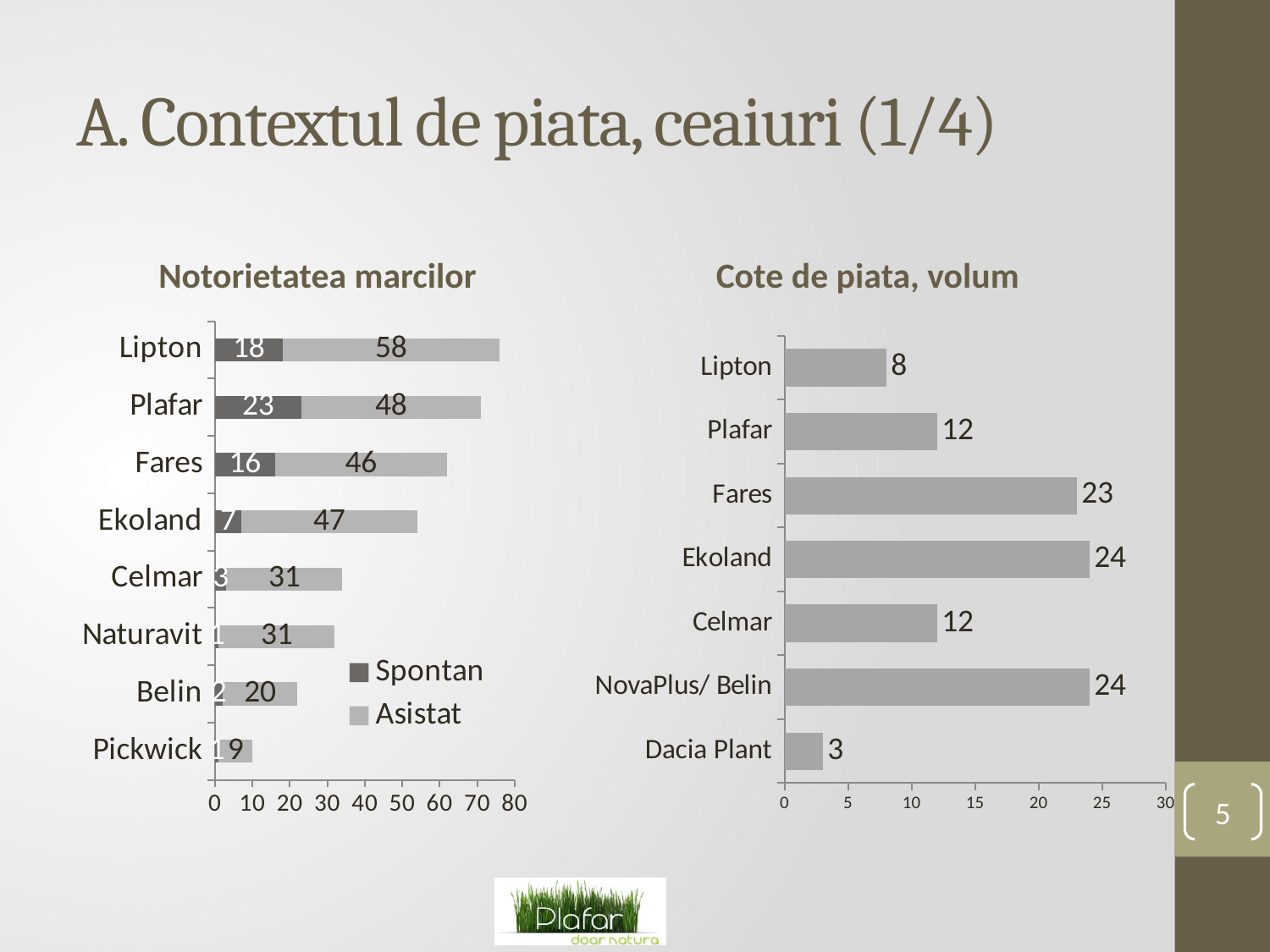
In the 'Cote de piata, volum' chart, which is larger, the value for Plafar or the value for Lipton? Plafar In the 'Notorietatea marcilor' chart, what is the Spontan value for Plafar? 23 In the 'Notorietatea marcilor' chart, what is the total of the stacked bar for Lipton? 76 How many series does the legend of the 'Notorietatea marcilor' chart list? 2 In the 'Notorietatea marcilor' chart, what is the Asistat value for Lipton? 58 In the 'Cote de piata, volum' chart, what is the value for Fares? 23 In the 'Cote de piata, volum' chart, which brand has the lowest value? Dacia Plant In the 'Notorietatea marcilor' chart, which brand has the highest Spontan value? Plafar How many brands are shown in the 'Notorietatea marcilor' chart? 8 What kind of chart is 'Cote de piata, volum'? Bar chart In the 'Notorietatea marcilor' chart, what is the difference between the Asistat values for Fares and Belin? 26 In the 'Cote de piata, volum' chart, what is the difference between the values for Ekoland and Celmar? 12